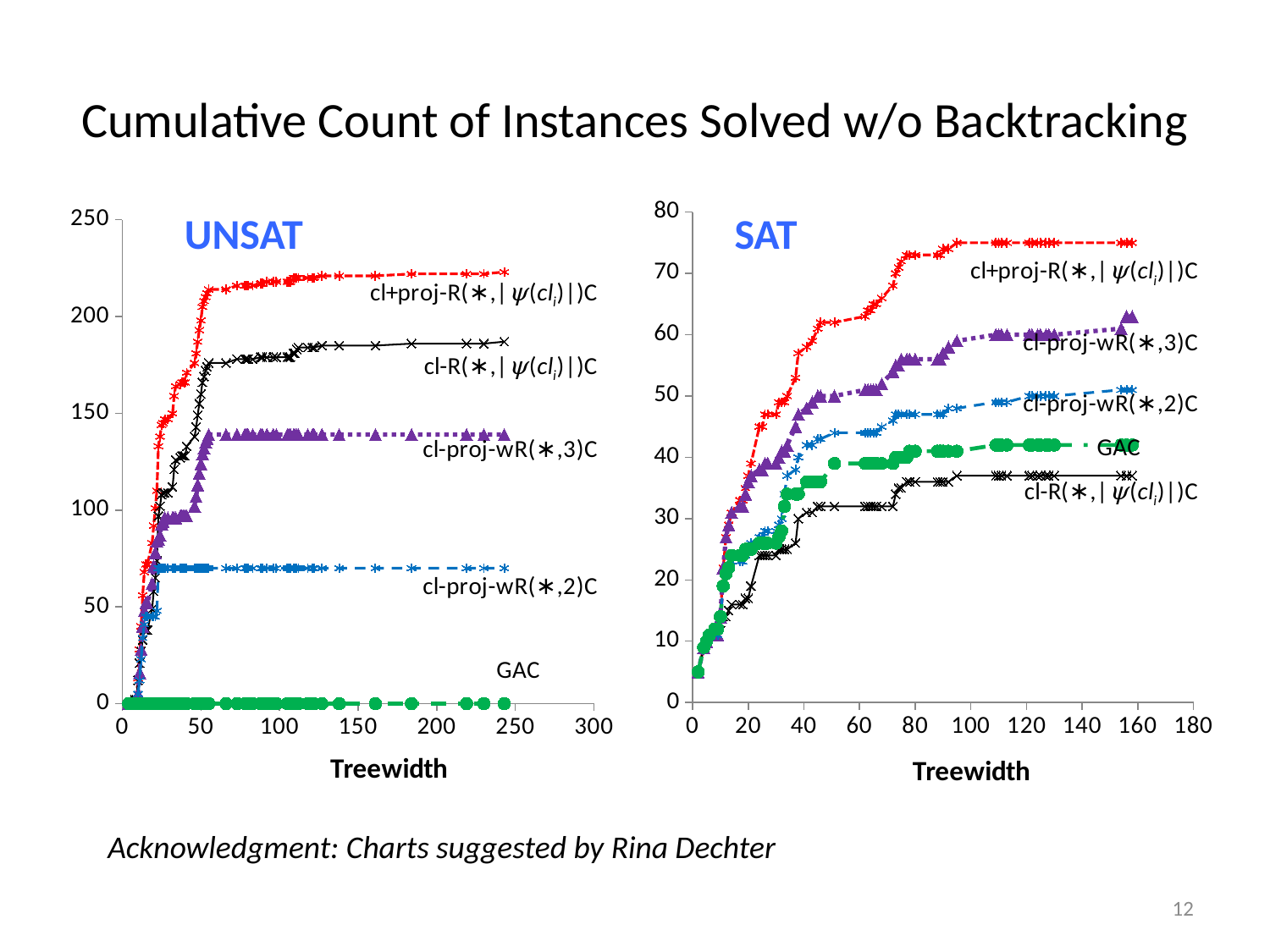
In the SAT chart, do the series rise or fall as treewidth increases? rise In the SAT chart, which series ends with the lowest cumulative count? cl-R(∗,|ψ(cl_i)|)C In the UNSAT chart, which series reaches the highest cumulative count? cl+proj-R(∗,|ψ(cl_i)|)C In the UNSAT chart, is the final value for cl+proj-R(∗,|ψ(cl_i)|)C greater or less than 200? greater How many series are plotted in the UNSAT chart? 5 In the SAT chart, which series reaches the highest cumulative count? cl+proj-R(∗,|ψ(cl_i)|)C In the SAT chart, which is larger at the right end: GAC or cl-R(∗,|ψ(cl_i)|)C? GAC In the UNSAT chart, which series has the lowest cumulative count? GAC In the SAT chart, is the final value for GAC greater or less than 50? less In the UNSAT chart, is the final value for cl-proj-wR(∗,2)C greater or less than 100? less What kind of chart is the UNSAT chart? line chart